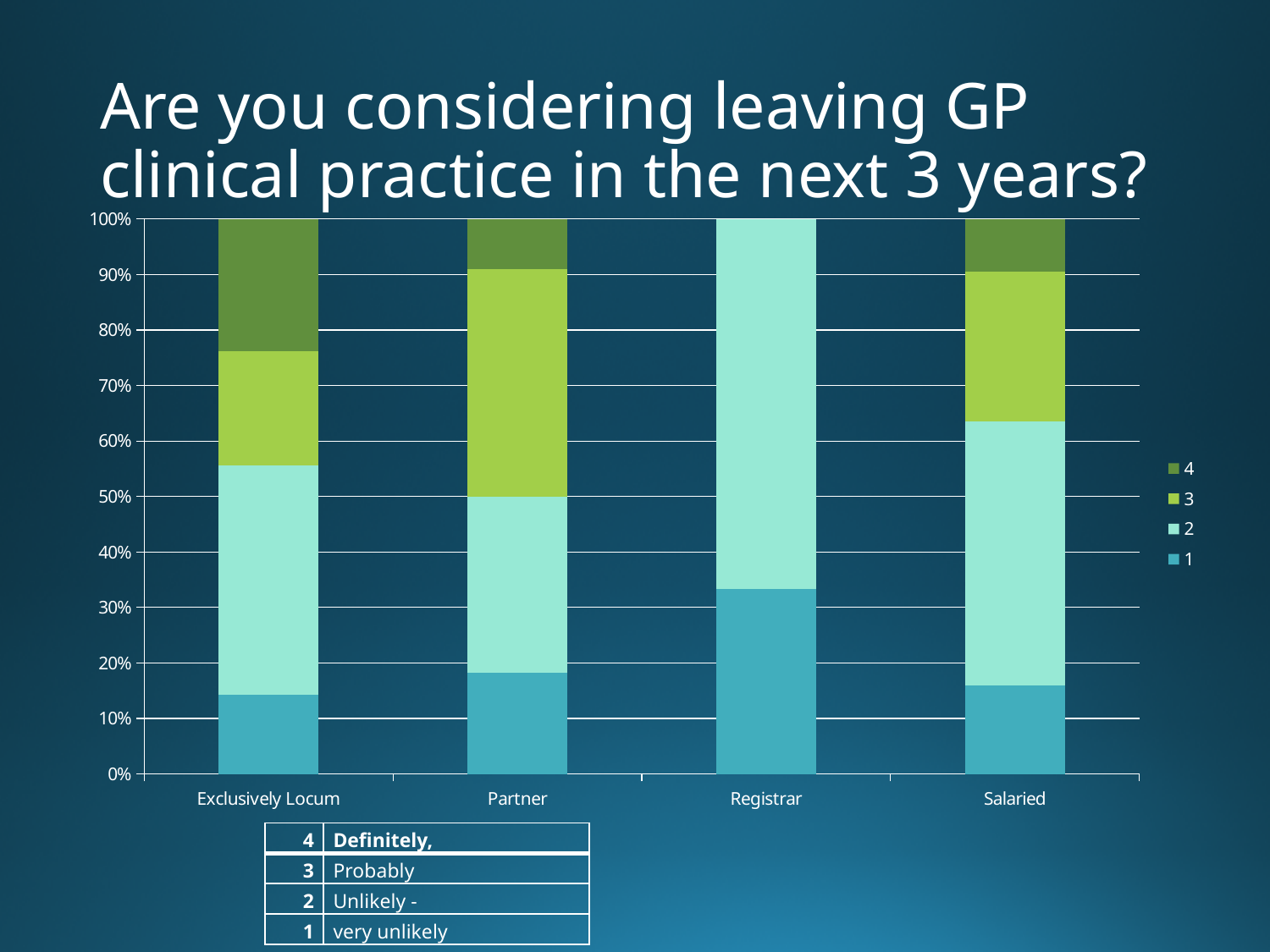
According to the key below the chart, what does the value 4 stand for? Definitely How many categories are shown on the x axis of the chart? 4 Which category has the largest share for series 1? Registrar Which category has the largest share for series 4? Exclusively Locum What kind of chart is shown on the slide? Stacked bar chart Which category has the smallest share for series 2? Partner Is the share for series 1 in the Exclusively Locum bar greater or less than 20%? less How many series does the chart's legend list? 4 Is the share for series 2 in the Registrar bar greater or less than 60%? greater Is the share for series 1 in the Registrar bar greater or less than 30%? greater Is the share for series 3 larger for Partner or for Exclusively Locum? Partner What is the title of the chart? Are you considering leaving GP clinical practice in the next 3 years?